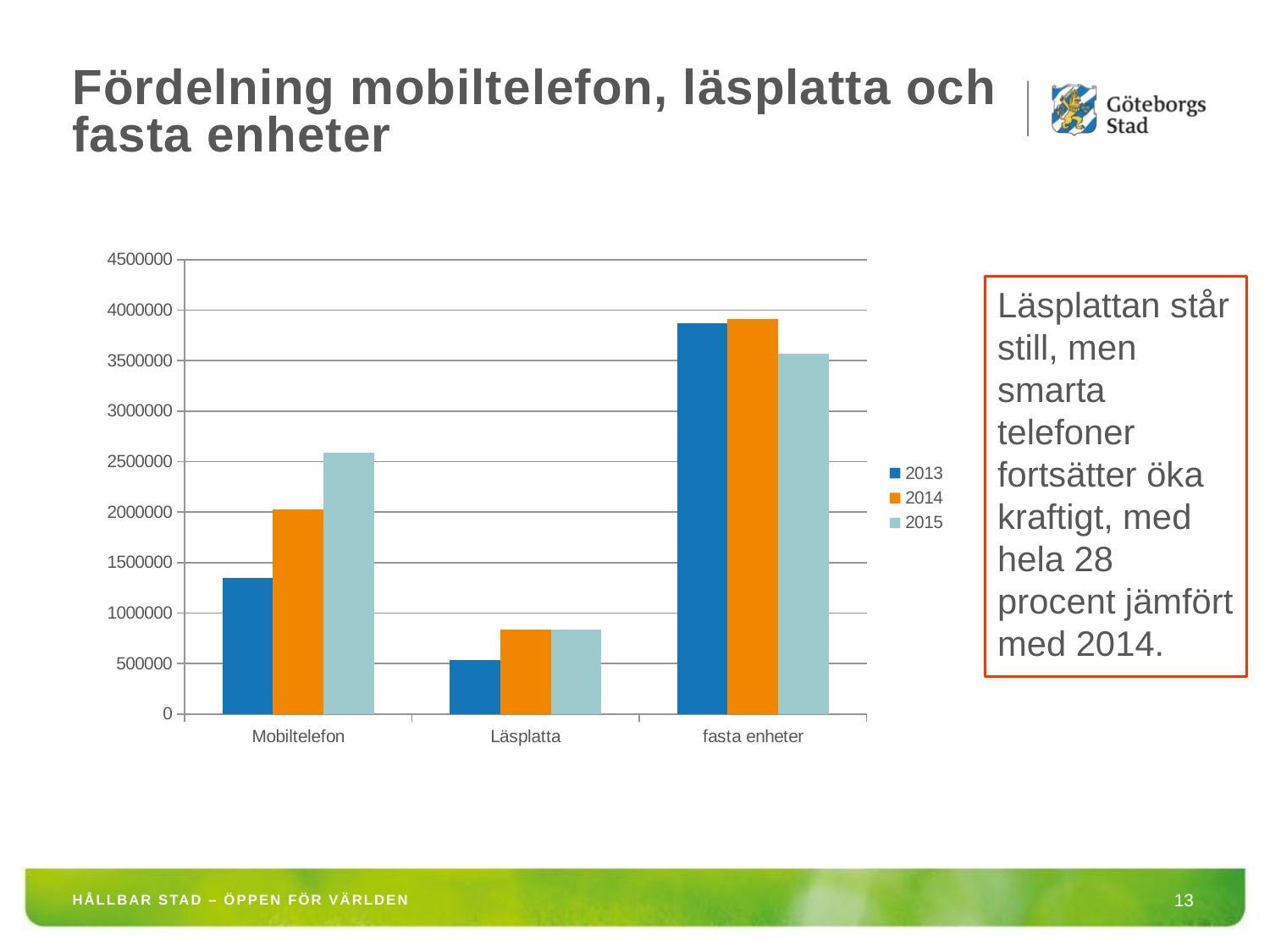
Which is larger for 2015: Mobiltelefon or Läsplatta? Mobiltelefon How many categories are shown on the x axis of the chart? 3 How many series does the chart's legend list? 3 Do the values for Mobiltelefon rise or fall from 2013 to 2015? rise Is the value for Läsplatta in 2013 greater or less than 1000000? less Is the value for Mobiltelefon in 2015 greater or less than 2000000? greater Which years are listed in the chart's legend? 2013, 2014, 2015 Which category has the highest value for 2015? fasta enheter Which category has the lowest value for 2013? Läsplatta Is the value for Mobiltelefon in 2013 greater or less than 1500000? less What kind of chart is shown on the slide? bar chart